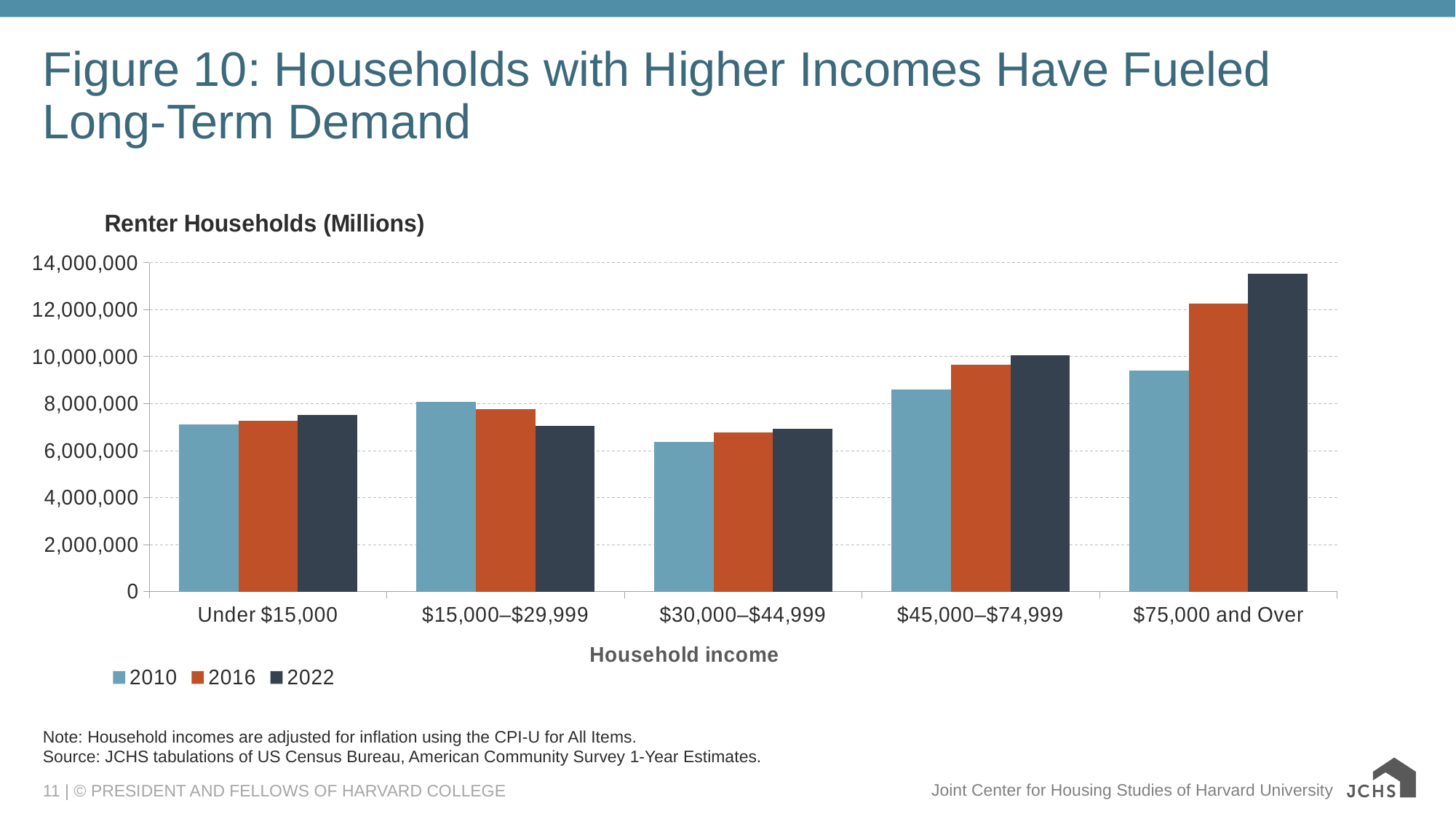
What kind of chart is shown on the slide? Bar chart Is the 2022 value for $75,000 and Over greater or less than 12,000,000? greater Is the 2010 value for $30,000–$44,999 greater or less than 8,000,000? less Which household income category has the lowest value for 2010? $30,000–$44,999 Which household income category has the highest value for 2022? $75,000 and Over Is the 2016 value for $45,000–$74,999 greater or less than 8,000,000? greater For the $15,000–$29,999 category, do the values rise or fall from 2010 to 2022? fall How many series does the legend list? 3 For the $15,000–$29,999 category, which is larger: the 2010 value or the 2022 value? 2010 How many household income categories are shown on the x axis? 5 For the $75,000 and Over category, do the values rise or fall from 2010 to 2022? rise What is the title of the vertical axis of the chart? Renter Households (Millions)